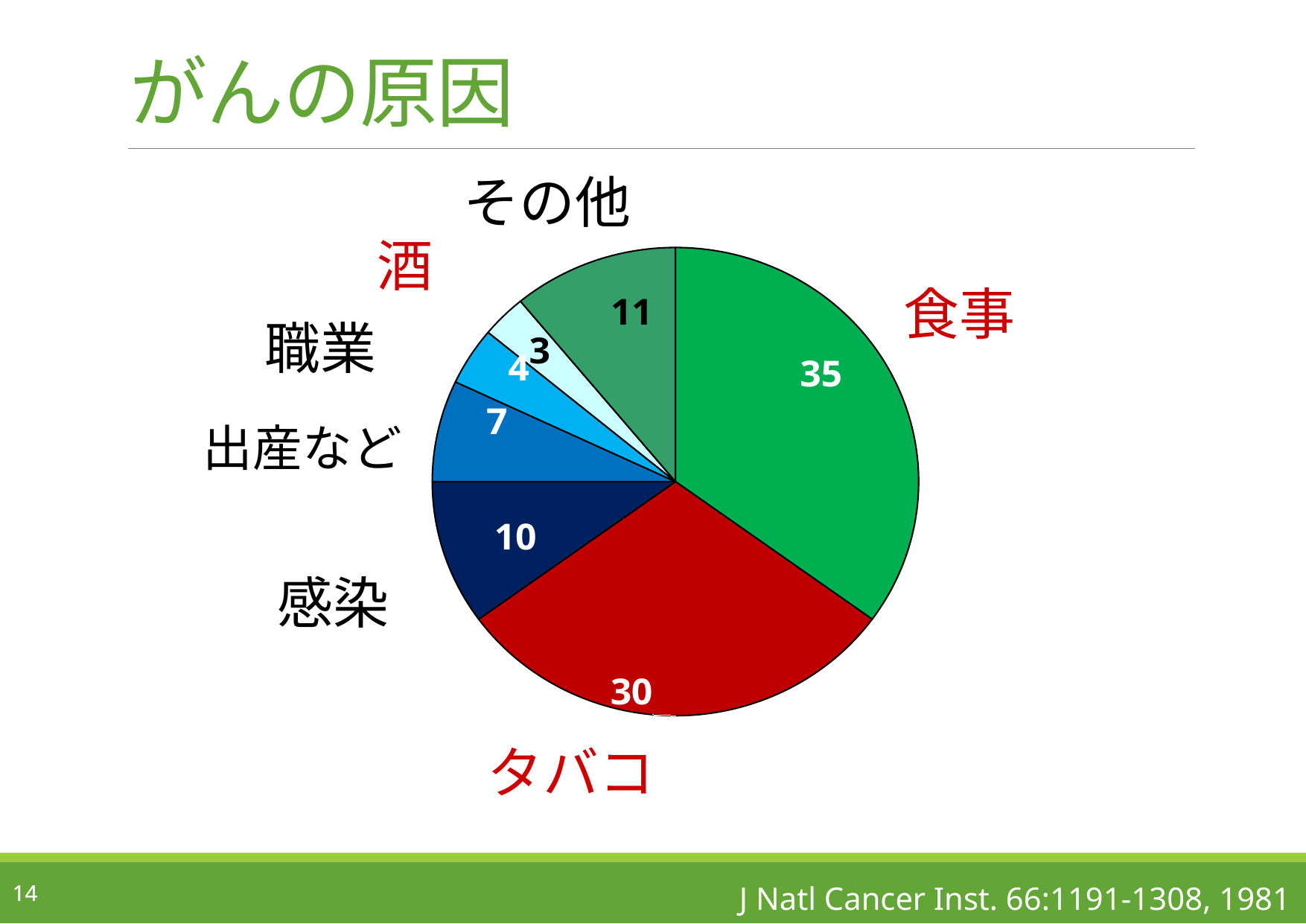
How many slices does the pie chart have? 7 What kind of chart is shown on the slide? pie chart What is the value for 食事 in the pie chart? 35 What is the value for 出産など in the pie chart? 7 What is the value for 酒 in the pie chart? 3 What is the value for タバコ in the pie chart? 30 Which category has the smallest slice in the pie chart? 酒 What is the difference between the values for 食事 and タバコ? 5 What is the title of the slide containing the pie chart? がんの原因 Which category has the largest slice in the pie chart? 食事 What is the value for 感染 in the pie chart? 10 Which is larger, the value for その他 or the value for 感染? その他